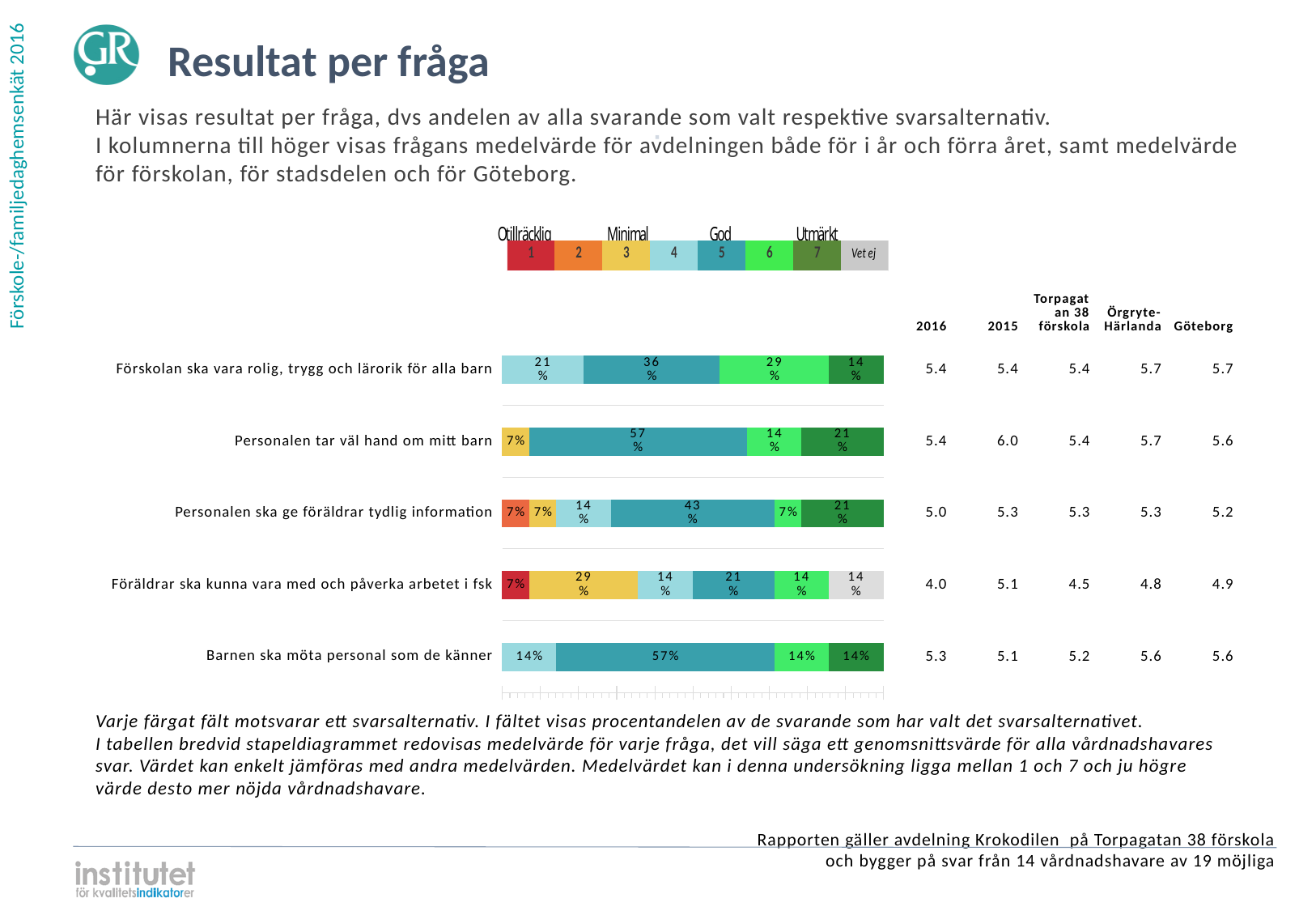
Which is larger: the option 7 segment for 'Personalen tar väl hand om mitt barn' or the option 7 segment for 'Förskolan ska vara rolig, trygg och lärorik för alla barn'? Personalen tar väl hand om mitt barn (21%) Which question is the only one with a red segment for response option 1? Föräldrar ska kunna vara med och påverka arbetet i fsk How many response categories does the legend above the chart list, including 'Vet ej'? 8 In the bar for 'Barnen ska möta personal som de känner', what is the difference between the option 5 segment (57%) and the option 4 segment (14%)? 43 percentage points Which question has the largest single segment in its bar? Personalen tar väl hand om mitt barn and Barnen ska möta personal som de känner (both 57%) How many questions (categories) are plotted in the bar chart? 5 In the bar for 'Personalen ska ge föräldrar tydlig information', what percentage chose response option 7 (the dark green segment)? 21% In the bar for 'Förskolan ska vara rolig, trygg och lärorik för alla barn', what percentage chose response option 6 (the bright green segment)? 29% What is the 2016 mean value shown for 'Föräldrar ska kunna vara med och påverka arbetet i fsk'? 4.0 What type of chart is shown on the slide? Stacked bar chart In the bar for 'Föräldrar ska kunna vara med och påverka arbetet i fsk', what percentage answered 'Vet ej' (the grey segment)? 14% In the bar for 'Personalen tar väl hand om mitt barn', what percentage chose response option 5 (the teal segment)? 57%